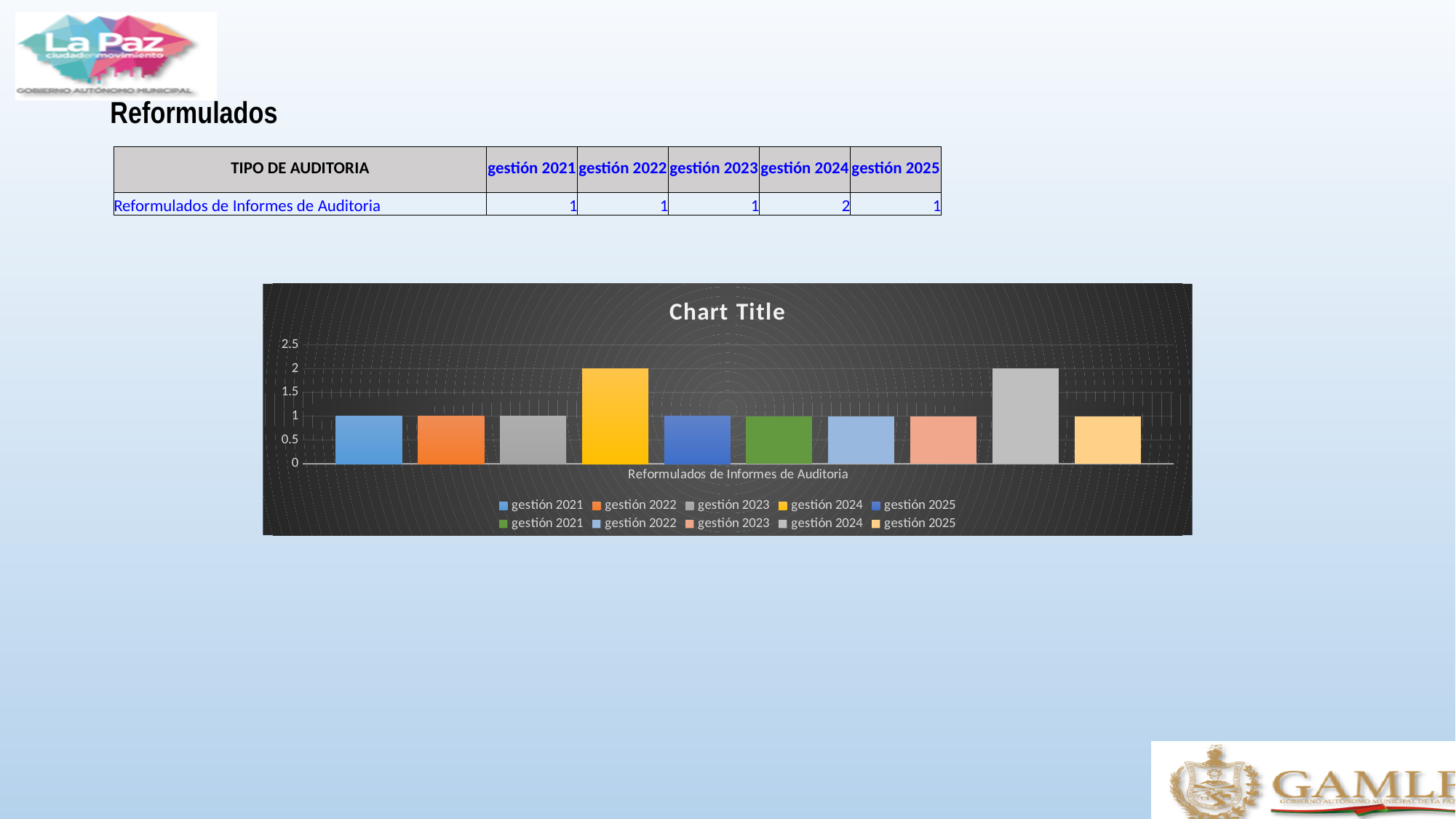
How many entries does the chart's legend list? 10 What is the value of the gestión 2021 bar in the chart? 1 Which is larger, the gestión 2024 value or the gestión 2023 value? gestión 2024 What is the value of the gestión 2024 bar in the chart? 2 How many bars are plotted in the chart? 10 Which series has the highest value in the chart? gestión 2024 Is the value for gestión 2024 greater or less than 1.5? greater What is the category label shown on the chart's horizontal axis? Reformulados de Informes de Auditoria What kind of chart is shown on the slide? bar chart What is the difference between the gestión 2024 value and the gestión 2021 value? 1 Is the value for gestión 2022 greater or less than 1.5? less What is the title shown on the chart? Chart Title